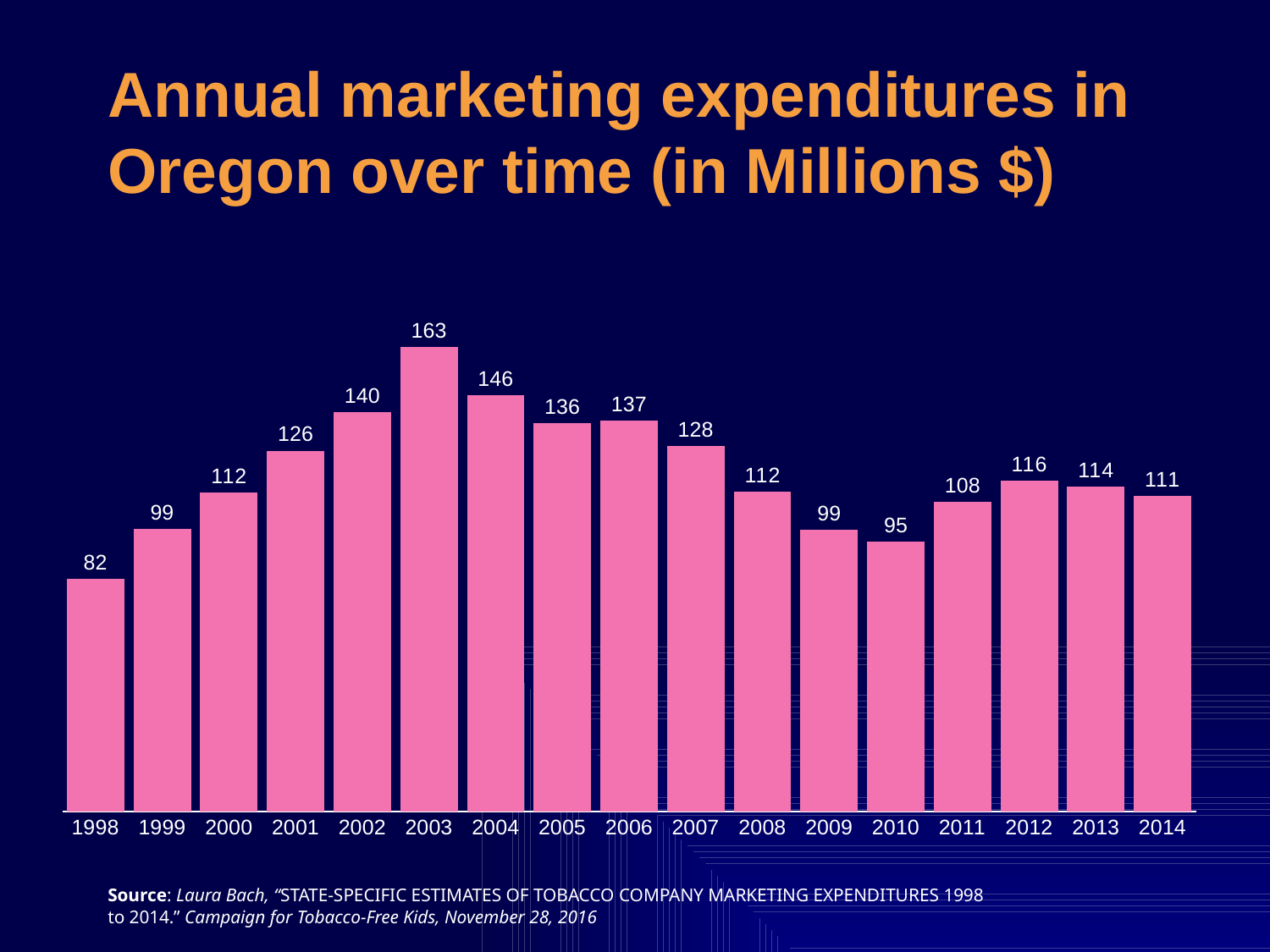
Which year has the lowest value? 1998 What is the title of the chart? Annual marketing expenditures in Oregon over time (in Millions $) Do the values rise or fall from 1998 to 2003? rise How many years are shown on the x axis? 17 What is the difference between the values for 2002 and 2001? 14 What is the value for 2003? 163 What is the value for 1998? 82 What is the difference between the values for 2003 and 2014? 52 Which year has the highest value? 2003 What kind of chart is this? bar chart What is the value for 2010? 95 Which is larger, the value for 2004 or the value for 2007? 2004